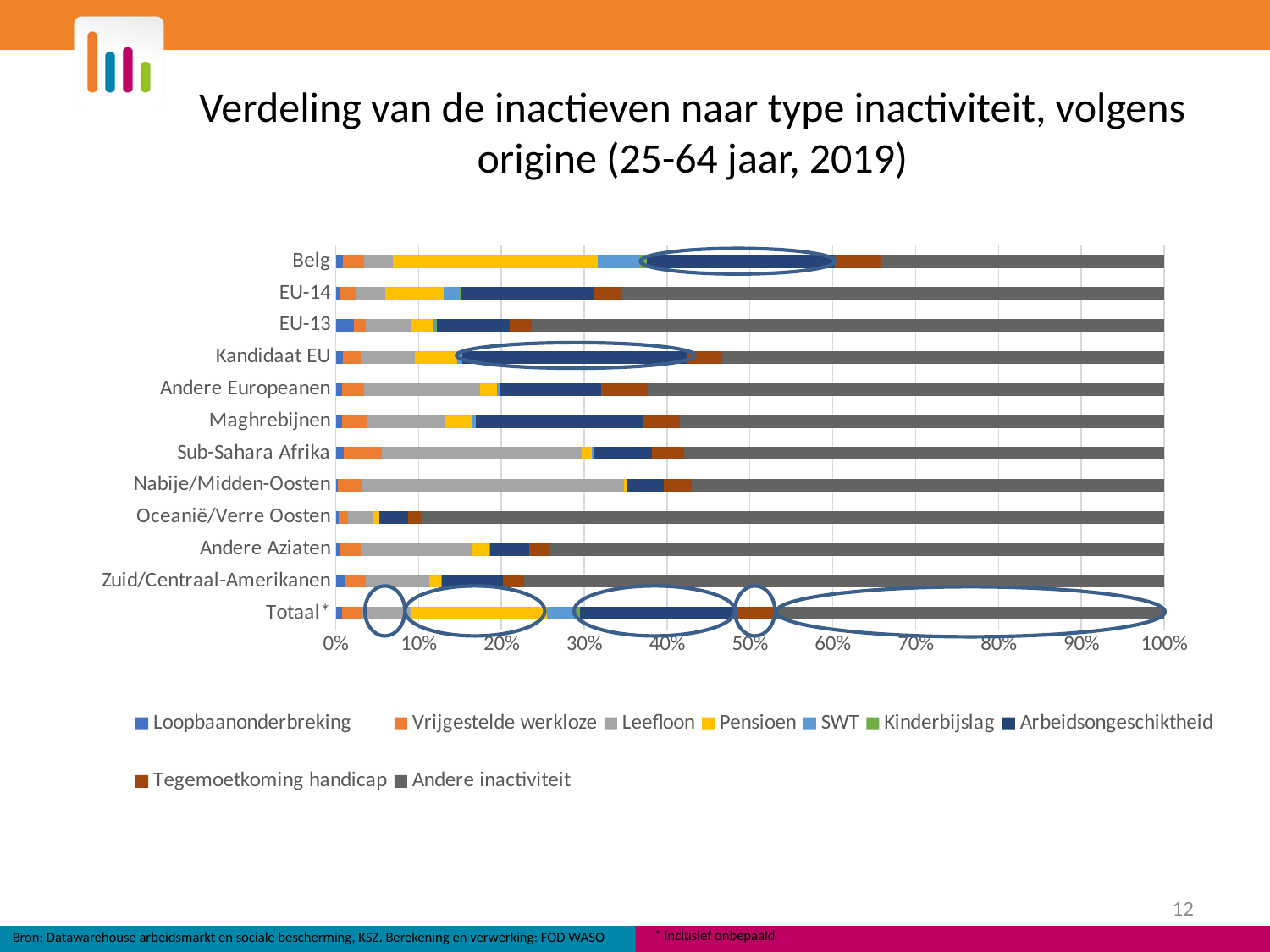
Is the Andere inactiviteit share for Oceanië/Verre Oosten greater or less than 80%? greater Which has the larger Leefloon segment, Nabije/Midden-Oosten or Belg? Nabije/Midden-Oosten How many series does the legend list? 9 Which category has the largest Pensioen segment? Belg Is the Andere inactiviteit share for Belg greater or less than 50%? less How many origin categories are plotted on the chart? 12 What kind of chart is shown on the slide? Stacked bar chart Which series is listed last in the legend? Andere inactiviteit Is the Pensioen share for Belg greater or less than 10%? greater What is the title of the chart? Verdeling van de inactieven naar type inactiviteit, volgens origine (25-64 jaar, 2019) Which category has the largest Andere inactiviteit segment? Oceanië/Verre Oosten Which has the larger Pensioen segment, Belg or EU-13? Belg